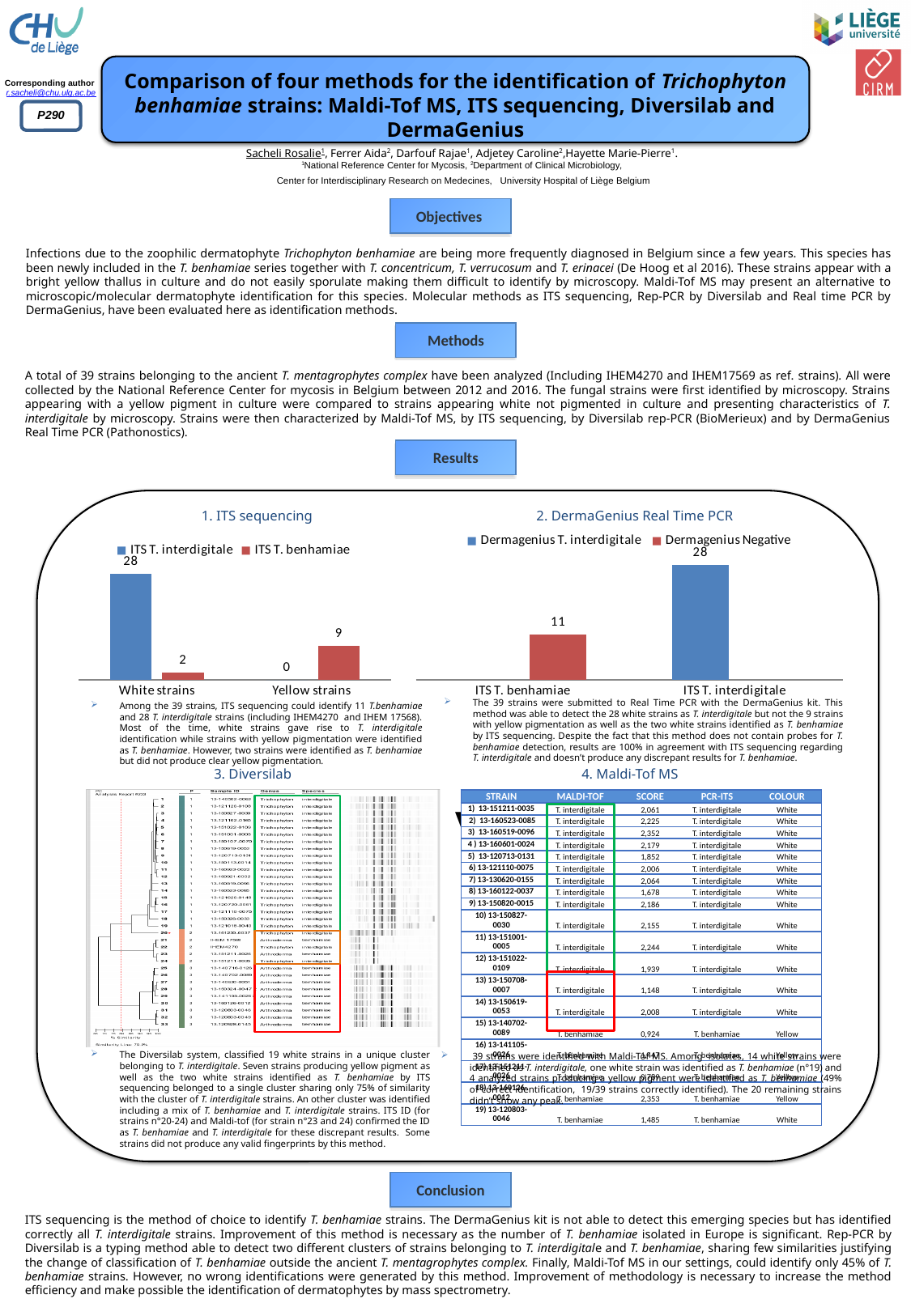
In the '1. ITS sequencing' chart, how many series does the legend list? 2 In the '1. ITS sequencing' chart, what is the value for ITS T. benhamiae among Yellow strains? 9 In the '1. ITS sequencing' chart, what is the value for ITS T. interdigitale among White strains? 28 In the '2. DermaGenius Real Time PCR' chart, what is the value for the ITS T. benhamiae category? 11 In the '1. ITS sequencing' chart, how many categories are shown on the x axis? 2 What kind of chart is the '2. DermaGenius Real Time PCR' chart? Bar chart In the '2. DermaGenius Real Time PCR' chart, what is the value for the ITS T. interdigitale category? 28 In the '2. DermaGenius Real Time PCR' chart, which series does the legend list in red? Dermagenius Negative In the '1. ITS sequencing' chart, what is the value for ITS T. interdigitale among Yellow strains? 0 In the '1. ITS sequencing' chart, what is the value for ITS T. benhamiae among White strains? 2 In the '1. ITS sequencing' chart, what is the difference between the ITS T. interdigitale and ITS T. benhamiae values for White strains? 26 In the '2. DermaGenius Real Time PCR' chart, which category has the higher value? ITS T. interdigitale